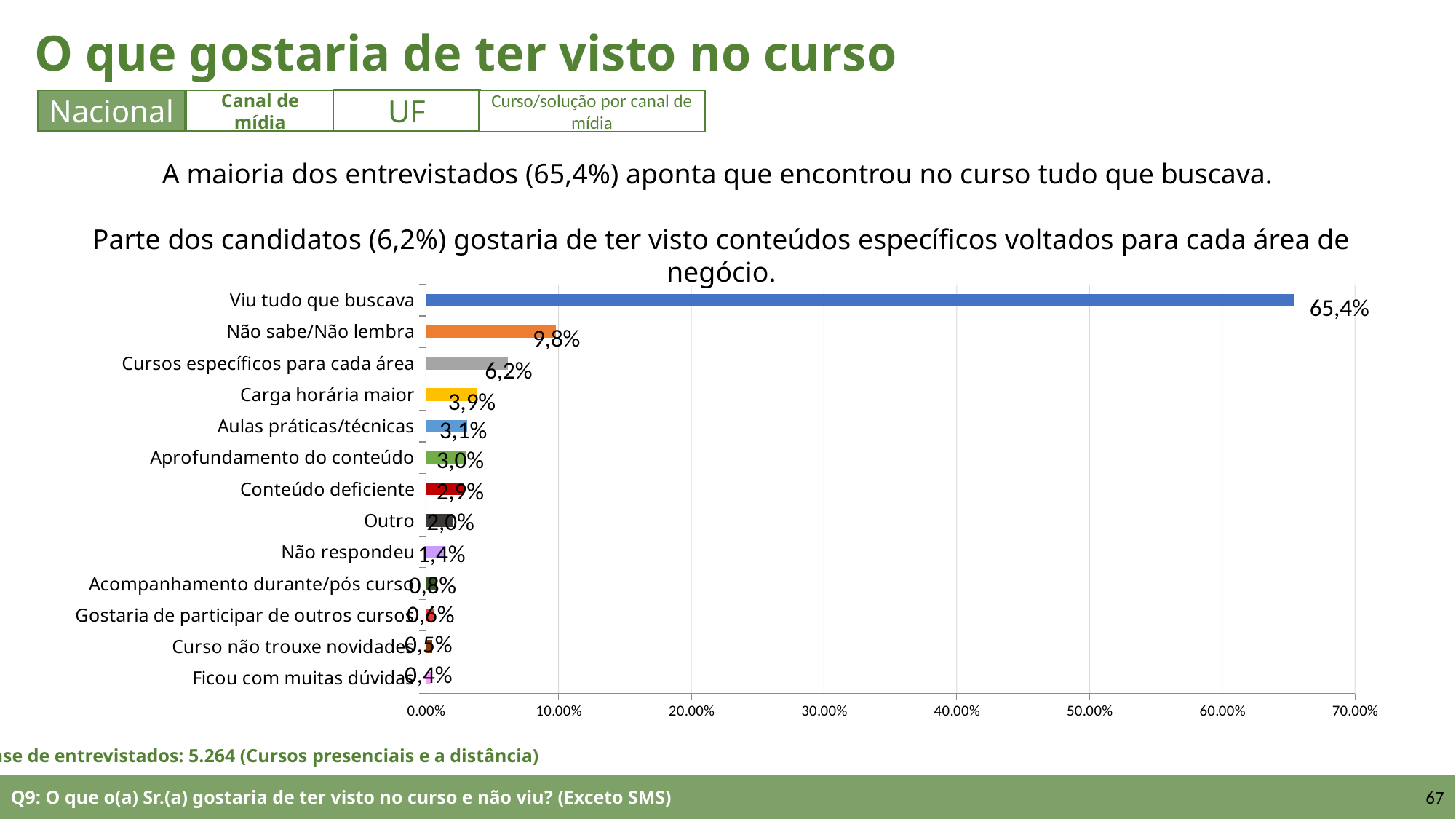
Is the value for "Viu tudo que buscava" greater or less than 60.00%? greater How many categories are shown in the chart? 13 Which category has the lowest value? Ficou com muitas dúvidas What is the value for "Outro"? 2,0% What is the difference between "Não sabe/Não lembra" and "Cursos específicos para cada área"? 3,6% What is the value for "Não sabe/Não lembra"? 9,8% What kind of chart is shown on the slide? Bar chart What is the value for "Viu tudo que buscava"? 65,4% What is the value for "Não respondeu"? 1,4% Which is larger, "Carga horária maior" or "Aulas práticas/técnicas"? Carga horária maior Which category has the highest value? Viu tudo que buscava What is the value for "Carga horária maior"? 3,9%